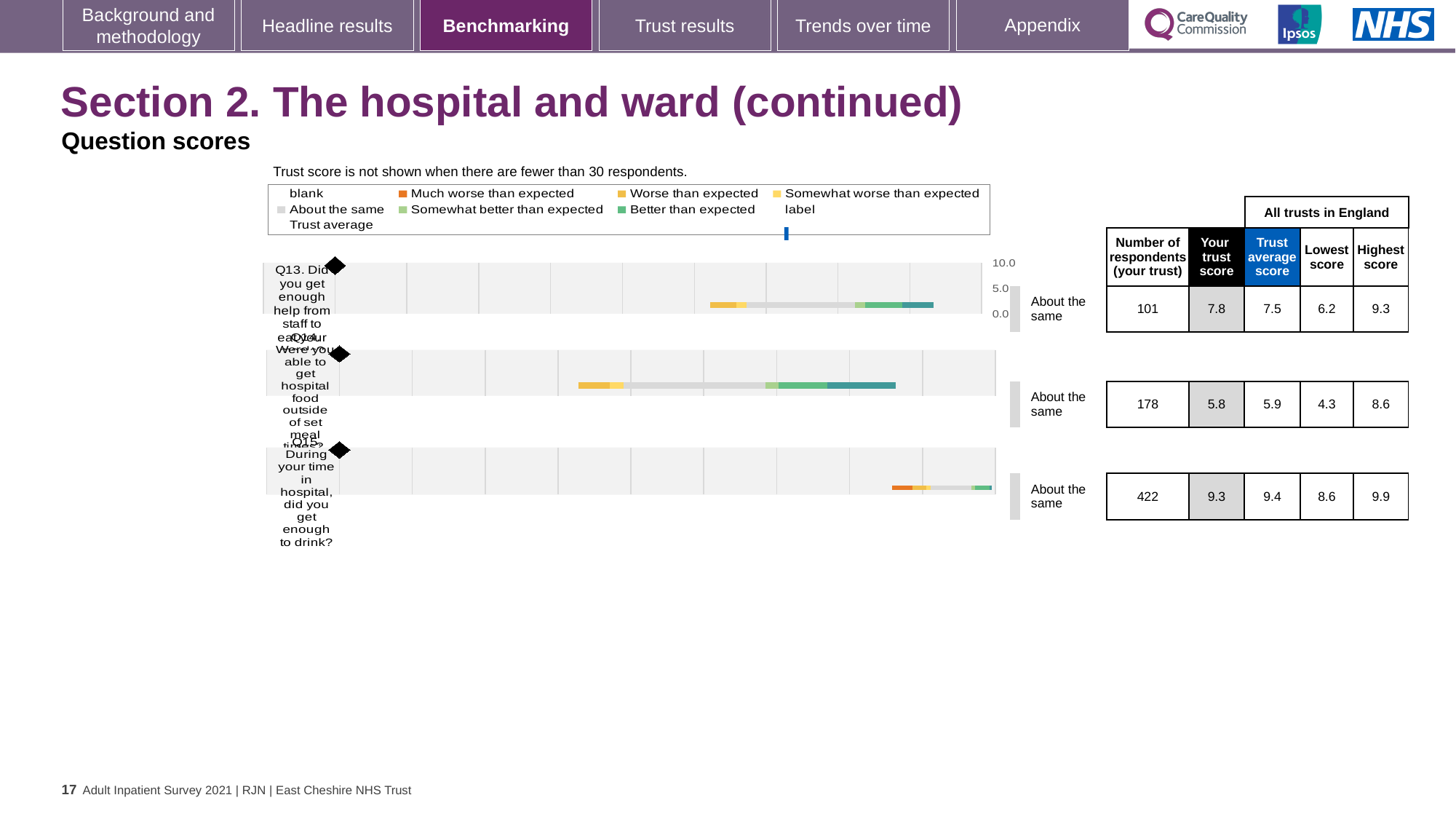
How many respondents from your trust answered Q15 (did you get enough to drink?)? 422 What is the 'Your trust score' for Q13 (Did you get enough help from staff to eat your meals?)? 7.8 What benchmark category is shown for Q14? About the same What is the highest score across all trusts in England for Q15? 9.9 What kind of chart is used to show the question scores on this slide? bar chart How many questions (categories) are plotted in the question scores chart? 3 Which question has the fewest respondents from your trust? Q13 What is the difference between the highest score and the lowest score for Q13? 3.1 What is the lowest score across all trusts in England for Q14? 4.3 Which question has the highest 'Your trust score'? Q15 For Q13, which is larger: your trust score or the trust average score? Your trust score What is the trust average score for Q14 (Were you able to get hospital food outside of set meal times?)? 5.9